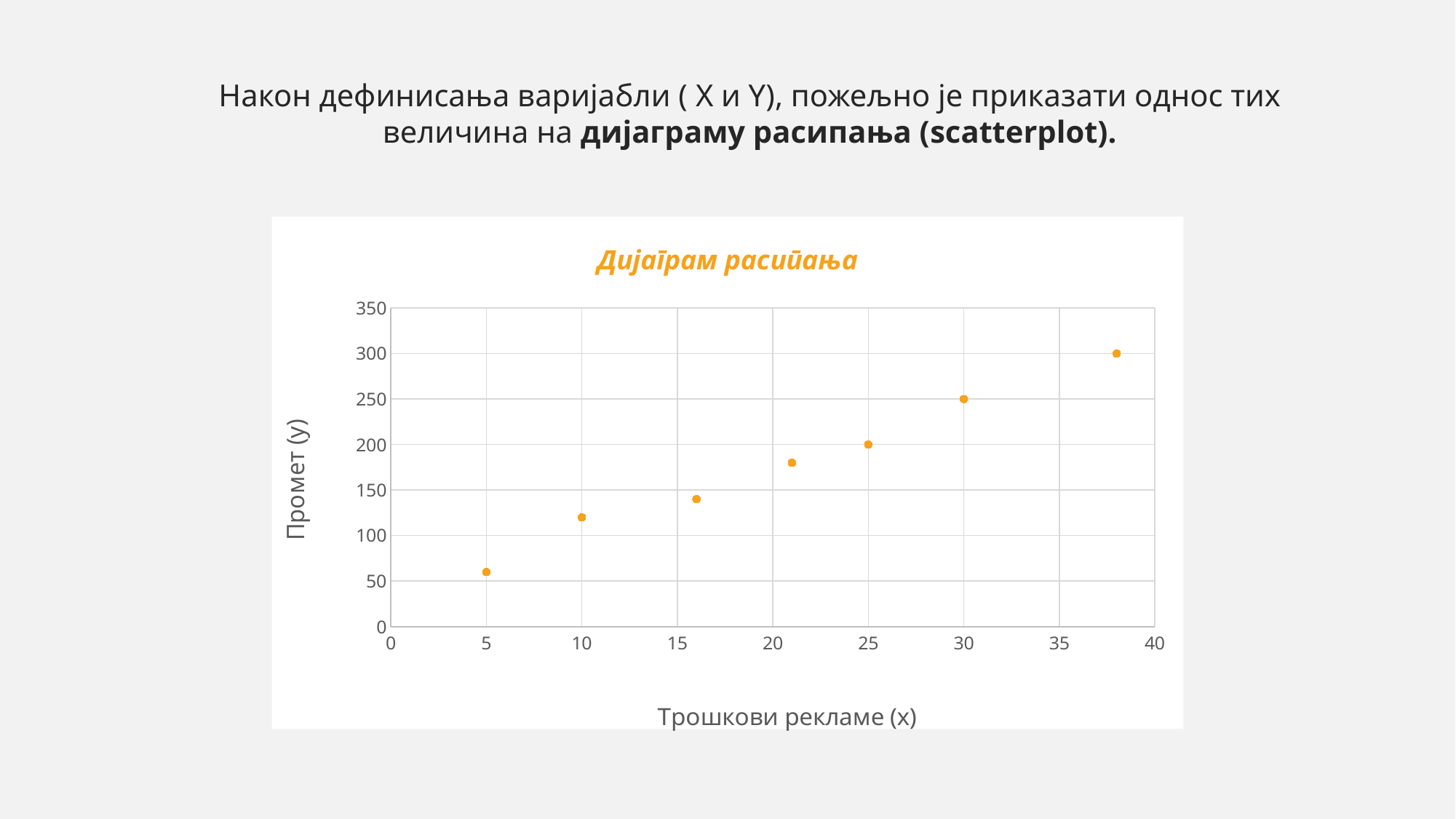
Is the Промет (y) value for the point at x = 21 greater or less than 150? greater What is the Промет (y) value of the rightmost point on the chart? 300 What kind of chart is shown on the slide? Scatter plot Do the values of Промет (y) rise or fall as Трошкови рекламе (x) increases? Rise Which point has the highest Промет (y) value, the one at x = 30 or the one at x = 38? The one at x = 38 Is the Промет (y) value for the point at x = 5 greater or less than 100? less What is the label of the horizontal axis? Трошкови рекламе (x) What is the Промет (y) value of the point at Трошкови рекламе (x) = 30? 250 Is the Промет (y) value for the point at x = 10 greater or less than 100? greater What is the Промет (y) value of the point at Трошкови рекламе (x) = 25? 200 How many data points are plotted on the chart? 7 What is the title of the chart? Дијаграм расипања